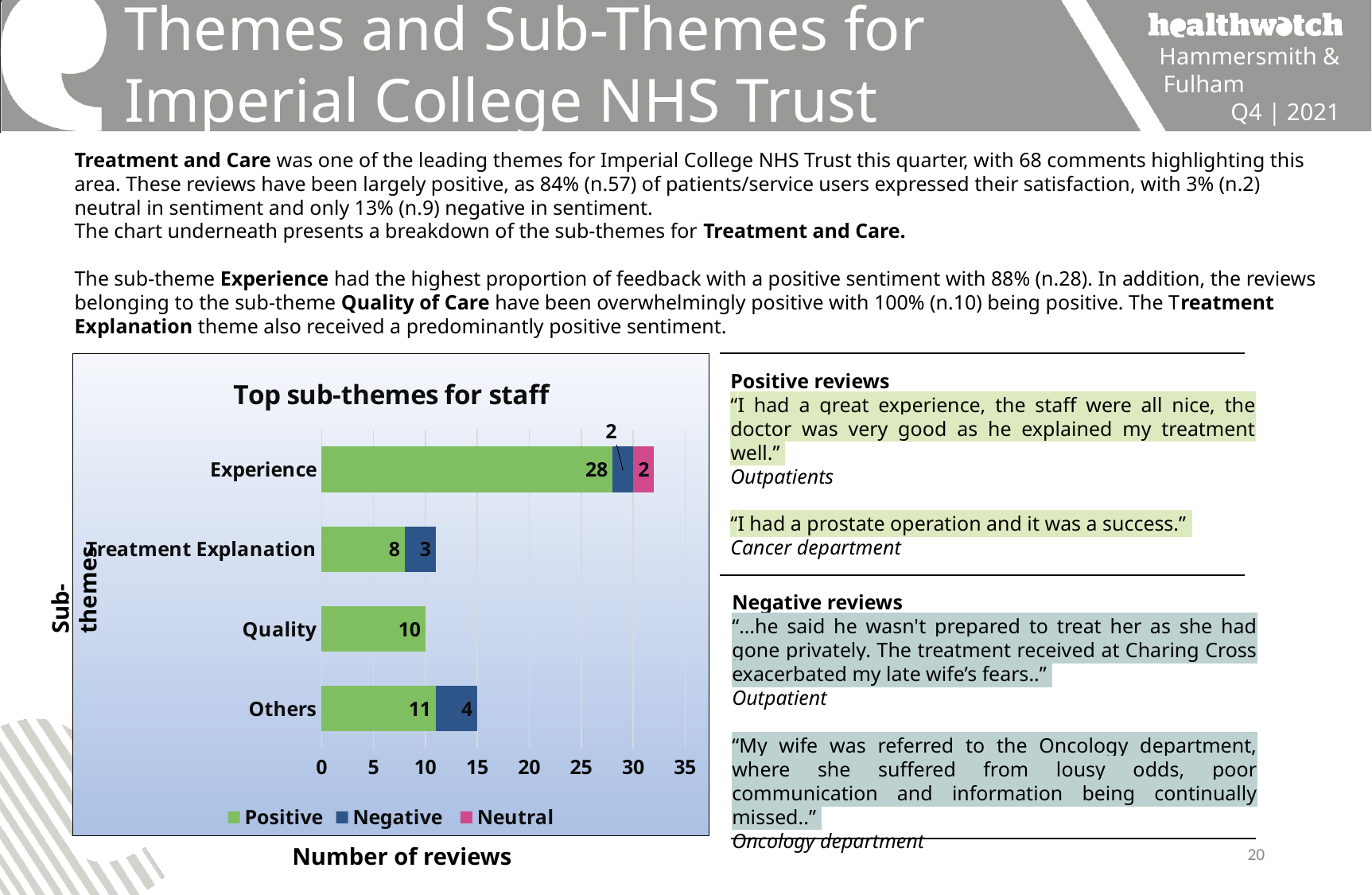
What is the difference between the Positive values for Experience and Others? 17 How many series does the legend list? 3 What is the Negative value for Others? 4 What is the Negative value for Treatment Explanation? 3 What kind of chart is shown? Stacked bar chart Which sub-theme has the lowest Positive value? Treatment Explanation Which sub-theme has the highest Positive value? Experience What is the total of the stacked bar for Experience? 32 What is the Positive value for Quality? 10 Which is larger, the Negative value for Others or the Negative value for Treatment Explanation? Others How many sub-themes are shown on the chart? 4 What is the Positive value for Experience? 28